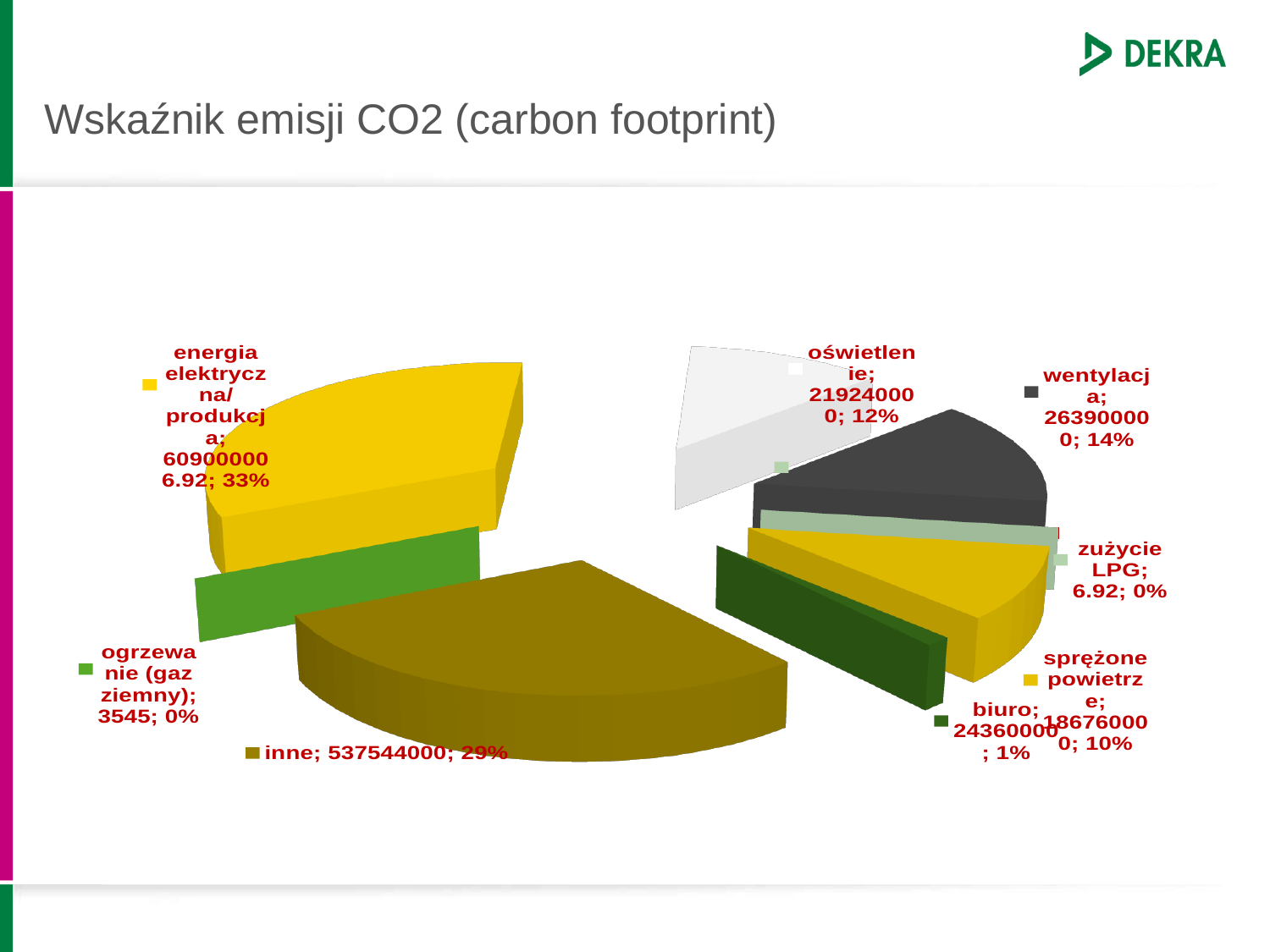
What percentage share does 'wentylacja' have? 14% What percentage share does the 'inne' slice have? 29% What value is shown for 'ogrzewanie (gaz ziemny)'? 3545 What kind of chart is shown on the slide? pie chart What value is shown for 'inne'? 537544000 What percentage share does 'biuro' have? 1% Which has a larger share, 'oświetlenie' or 'wentylacja'? wentylacja What value is shown for 'oświetlenie'? 219240000 Which category has the largest share of the pie? energia elektryczna/produkcja How many slices does the pie chart have? 8 What is the title of the chart on the slide? Wskaźnik emisji CO2 (carbon footprint)